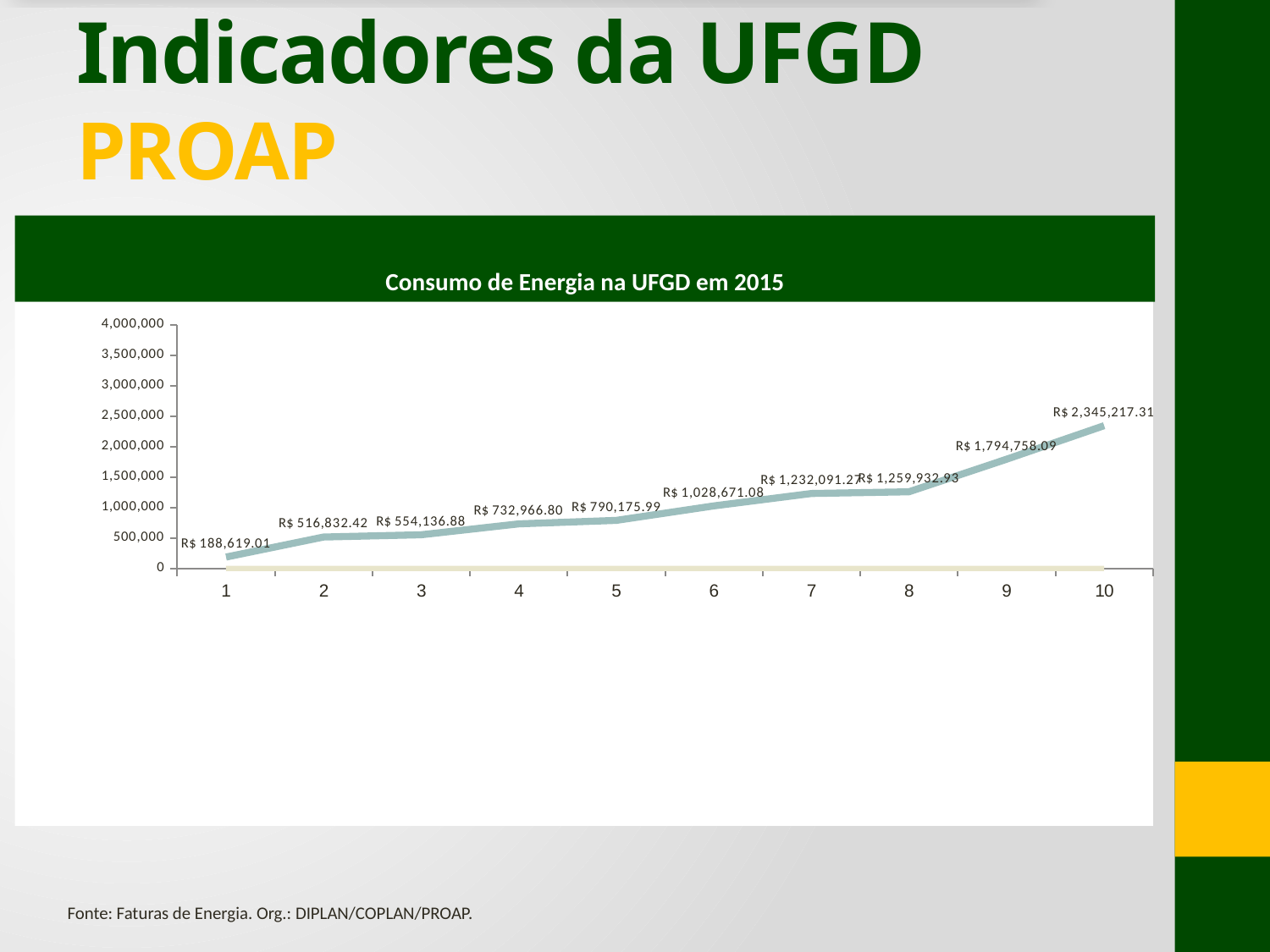
Which point on the x axis has the lowest value? 1 What is the value at point 9 on the x axis? R$ 1,794,758.09 Which point on the x axis has the highest value? 10 Is the value at point 10 greater or less than 2,000,000? greater What type of chart is shown under the title 'Consumo de Energia na UFGD em 2015'? Line chart Which is larger, the value at point 4 or the value at point 5? Point 5 What is the difference between the value at point 10 and the value at point 1? R$ 2,156,598.30 Do the values rise or fall from point 1 to point 10? Rise What is the value at point 1 on the x axis? R$ 188,619.01 How many points are plotted along the x axis? 10 What is the value at point 10 on the x axis? R$ 2,345,217.31 What is the value at point 6 on the x axis? R$ 1,028,671.08